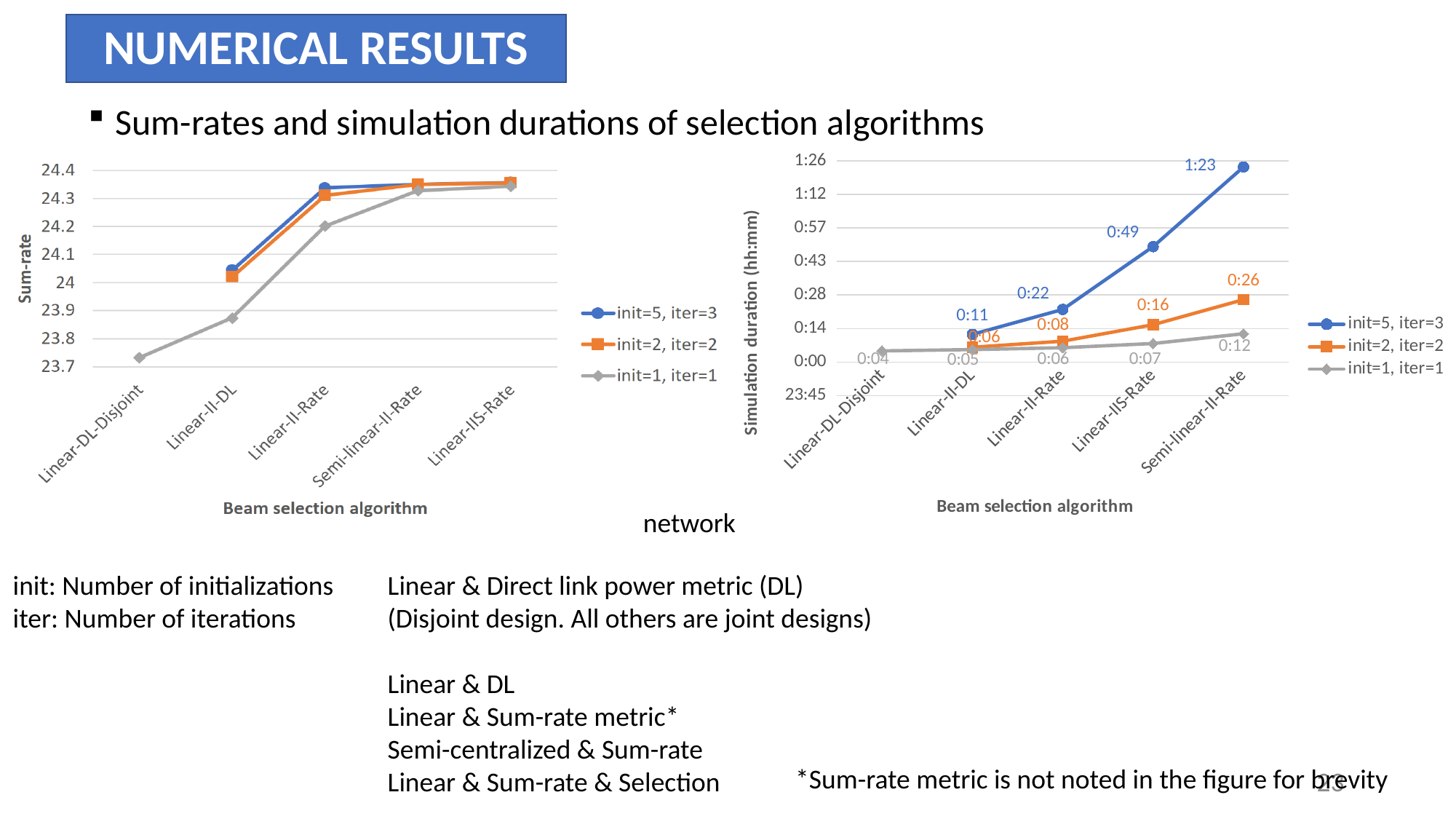
In the right chart (Simulation duration), which is larger for Linear-II-Rate: the init=5, iter=3 duration or the init=2, iter=2 duration? init=5, iter=3 What kind of chart is the right chart (Simulation duration)? line chart In the left chart (Sum-rate), how many beam selection algorithms are shown on the x axis? 5 How many series does the legend of the left chart (Sum-rate) list? 3 In the right chart (Simulation duration), does the init=5, iter=3 series rise or fall from Linear-II-DL to Semi-linear-II-Rate? rise In the right chart (Simulation duration), what is the difference between the init=5, iter=3 and init=2, iter=2 durations for Semi-linear-II-Rate? 0:57 In the left chart (Sum-rate), is the sum-rate for Linear-DL-Disjoint with init=1, iter=1 greater or less than 23.8? less In the left chart (Sum-rate), is the sum-rate for Linear-II-Rate with init=5, iter=3 greater or less than 24.3? greater In the right chart (Simulation duration), which beam selection algorithm has the highest simulation duration for the init=5, iter=3 series? Semi-linear-II-Rate In the right chart (Simulation duration), what is the simulation duration for Linear-IIS-Rate with init=2, iter=2? 0:16 In the right chart (Simulation duration), what is the simulation duration for Semi-linear-II-Rate with init=5, iter=3? 1:23 In the right chart (Simulation duration), what is the simulation duration for Linear-DL-Disjoint with init=1, iter=1? 0:04